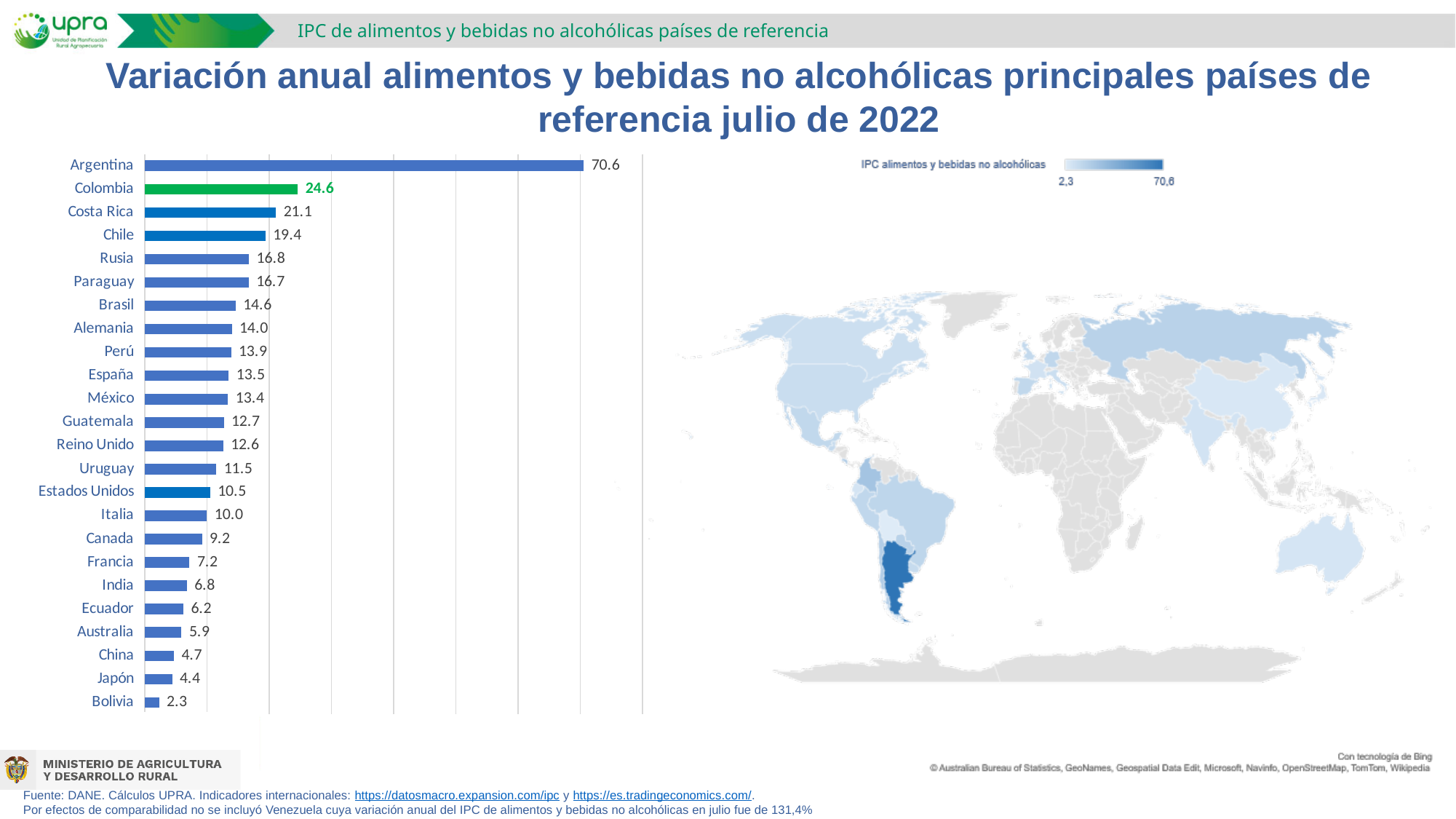
In the bar chart, which country's bar is coloured green? Colombia In the bar chart, which has a larger value, Francia or Ecuador? Francia In the bar chart, which country has the highest value? Argentina In the bar chart, what is the value for Colombia? 24.6 What kind of chart is shown on the left side of the slide? Bar chart In the bar chart, what is the difference between the values for Argentina and Colombia? 46.0 In the bar chart, what is the value for Japón? 4.4 In the bar chart, what is the difference between the values for Costa Rica and Chile? 1.7 In the bar chart, what is the value for Brasil? 14.6 How many countries are shown in the bar chart? 24 In the bar chart, which country has the lowest value? Bolivia In the bar chart, which has a larger value, Estados Unidos or Canada? Estados Unidos